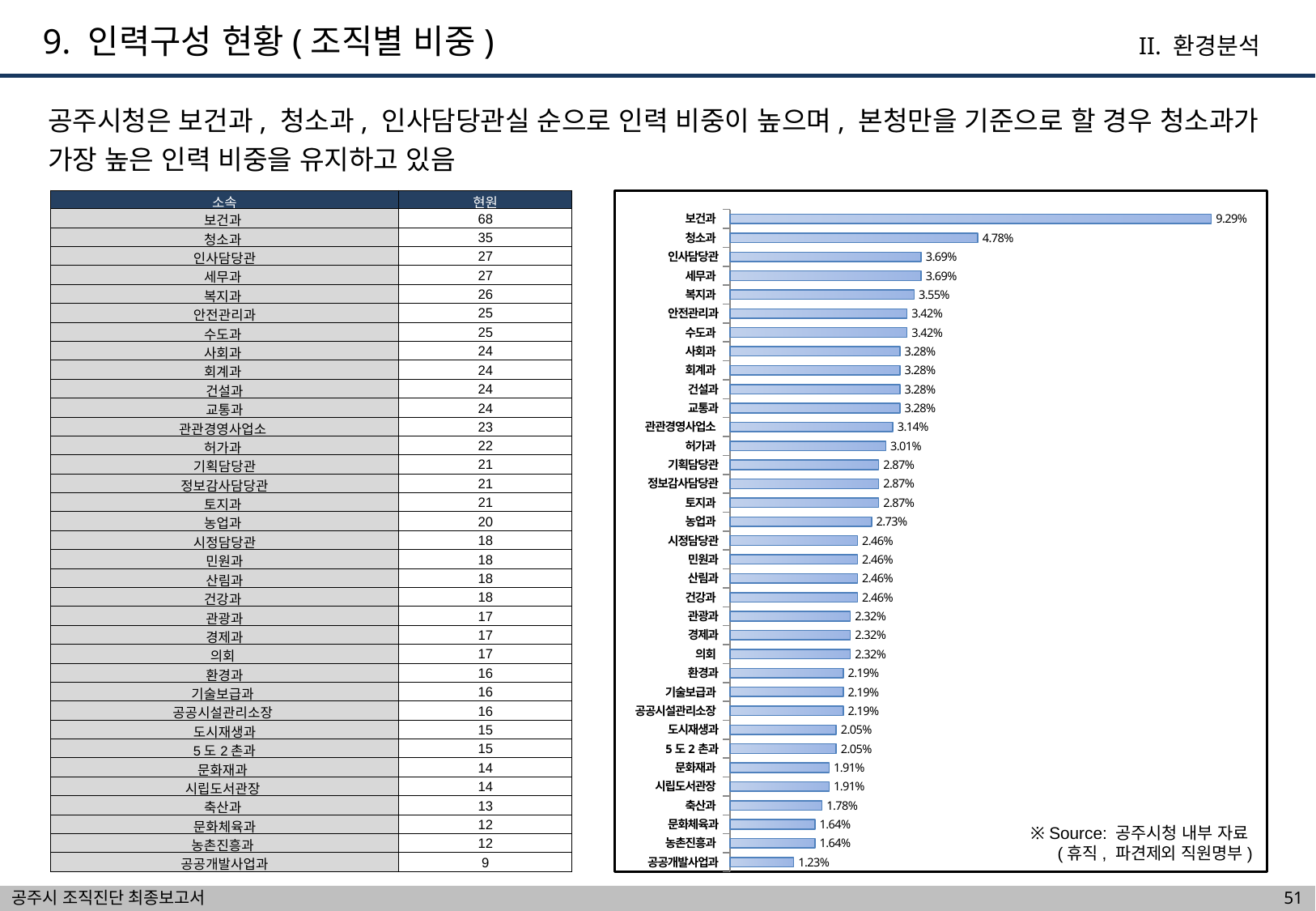
What is the value for 축산과 in the bar chart? 1.78% What is the difference between the values for 보건과 and 청소과 in the bar chart? 4.51% How many categories are plotted in the bar chart? 35 What is the value for 보건과 in the bar chart? 9.29% What kind of chart is shown on the slide? bar chart Which category has the highest value in the bar chart? 보건과 Which is larger in the bar chart, the value for 복지과 or the value for 농업과? 복지과 Which category has the lowest value in the bar chart? 공공개발사업과 What is the value for 허가과 in the bar chart? 3.01% Do the values in the bar chart rise or fall from the top category to the bottom category? fall What is the value for 청소과 in the bar chart? 4.78% What is the difference between the values for 인사담당관 and 공공개발사업과 in the bar chart? 2.46%